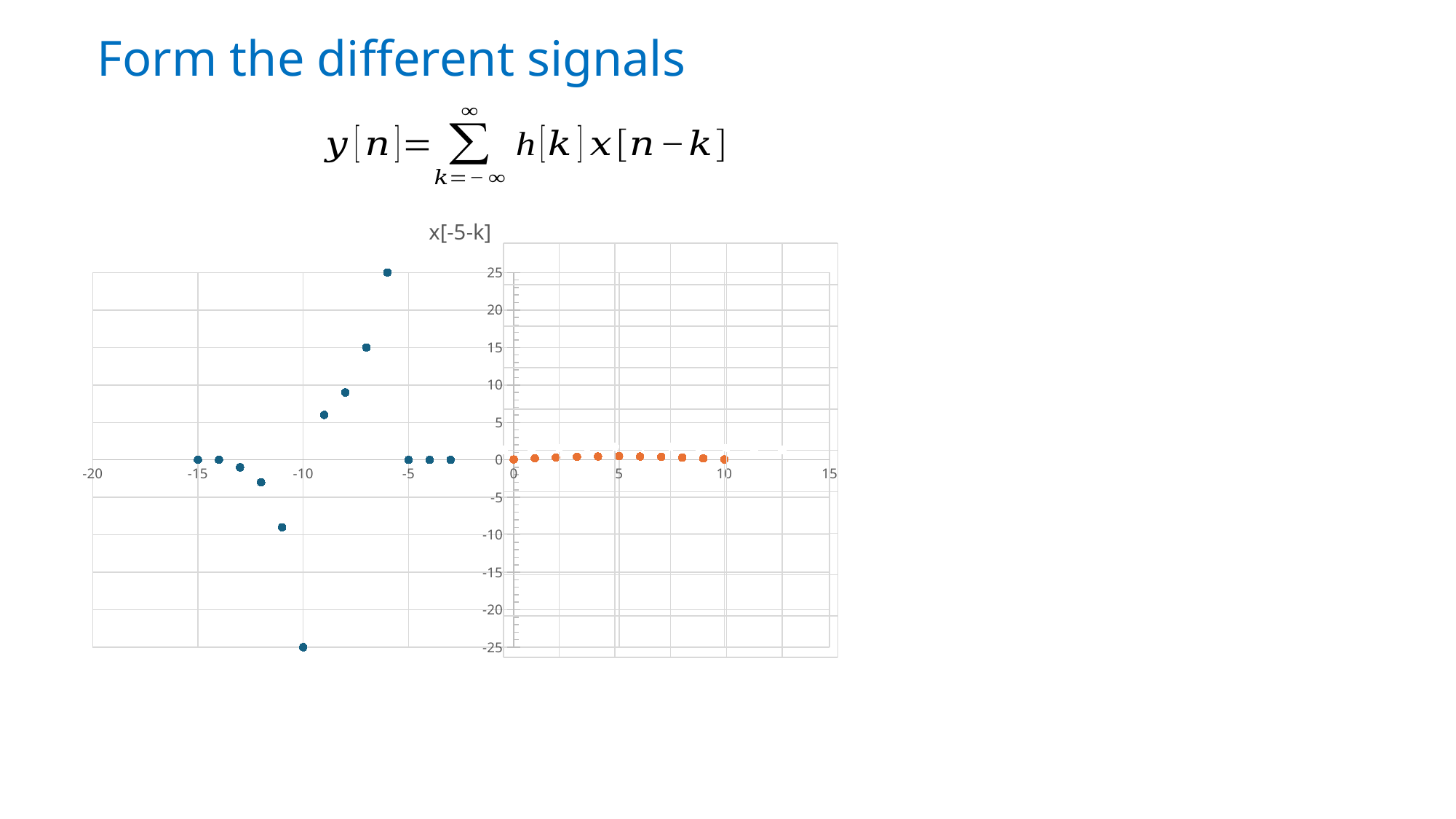
At which x value does the chart reach its highest point? -6 What is the value of the point at x = -10? -25 Which has the larger value, the point at x = -8 or the point at x = -9? x = -8 What is the title of the chart? x[-5-k] Is the value for x = -8 greater or less than 5? greater Do the values rise or fall as x goes from -9 to -6? rise What is the value of the point at x = -7? 15 Is the value for x = -11 greater or less than -5? less At which x value does the chart reach its lowest point? -10 What is the value of the point at x = -6? 25 What is the difference between the value at x = -6 and the value at x = -10? 50 What kind of chart is shown on the slide? scatter chart